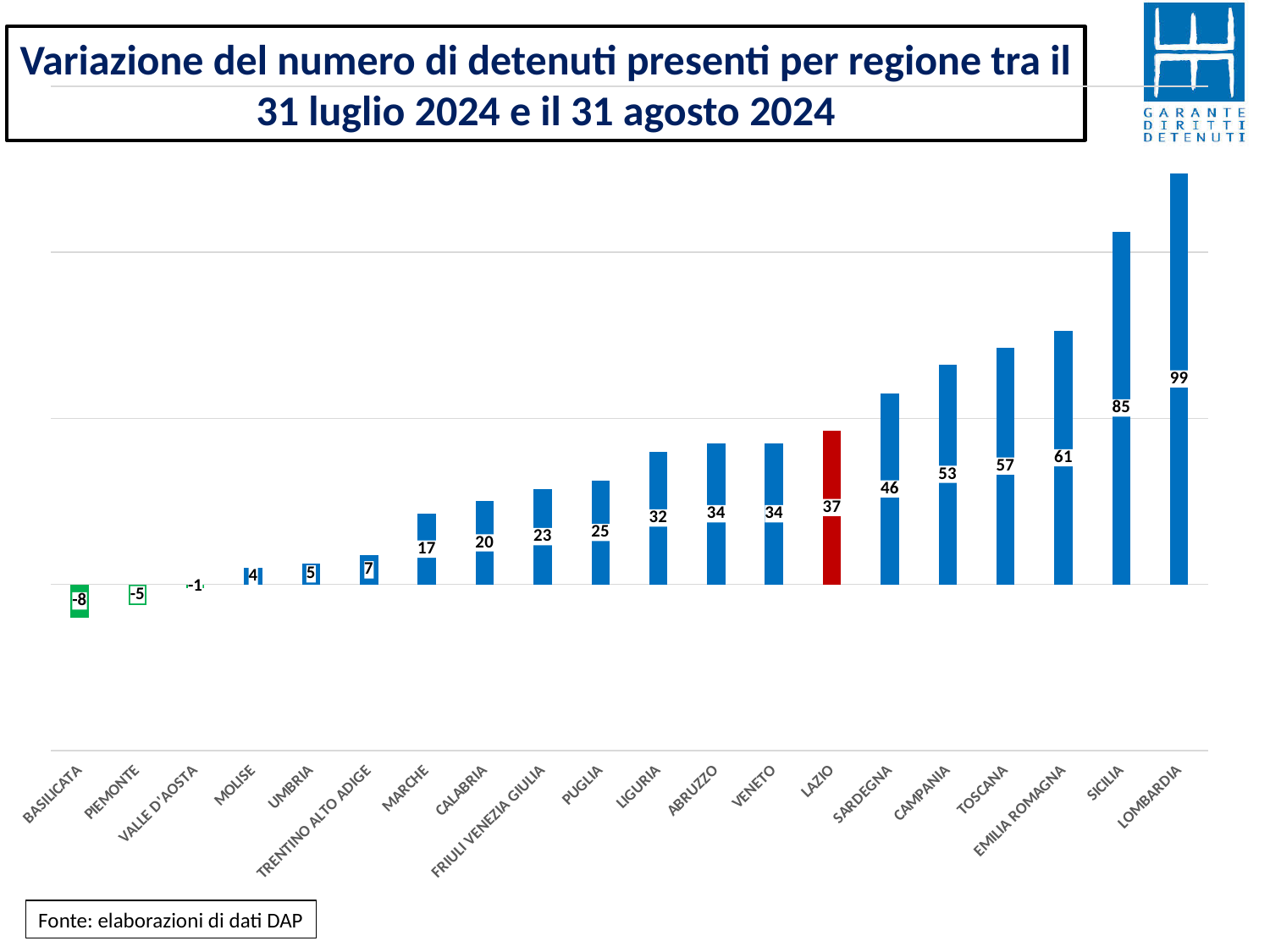
What is the difference between the values for EMILIA ROMAGNA and TOSCANA? 4 How many regions are shown on the x axis? 20 What is the value for LAZIO? 37 Do the values rise or fall from left to right along the x axis? rise What is the value for BASILICATA? -8 Which region's bar is coloured red? LAZIO What kind of chart is shown on the slide? bar chart What is the difference between the values for LOMBARDIA and SICILIA? 14 Which region has the lowest value? BASILICATA Which is larger, the value for CAMPANIA or the value for SARDEGNA? CAMPANIA Which region has the highest value? LOMBARDIA What is the value for SICILIA? 85